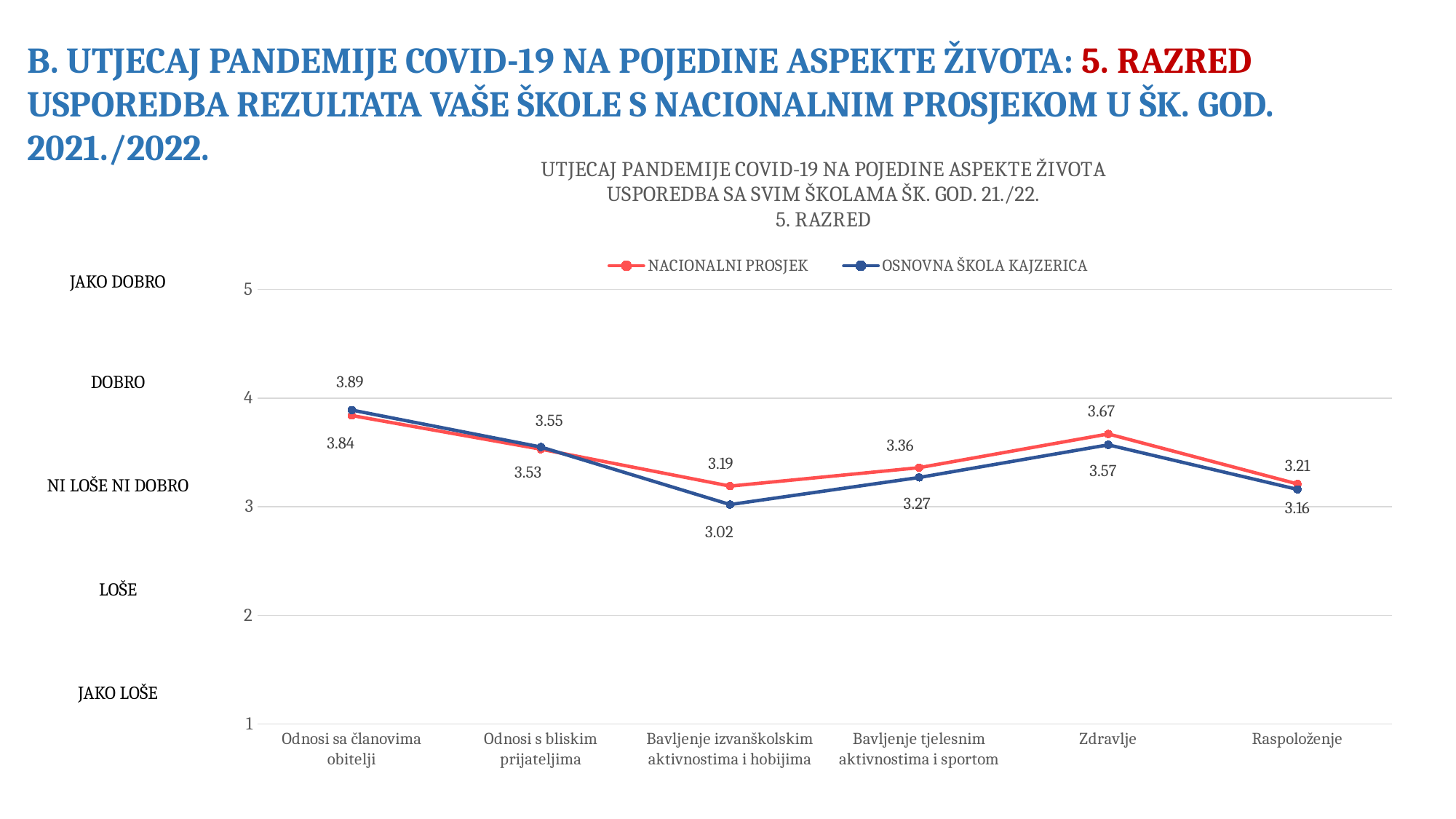
What is the OSNOVNA ŠKOLA KAJZERICA value for Bavljenje izvanškolskim aktivnostima i hobijima? 3.02 What is the NACIONALNI PROSJEK value for Bavljenje tjelesnim aktivnostima i sportom? 3.36 What is the NACIONALNI PROSJEK value for Zdravlje? 3.67 What is the difference between the NACIONALNI PROSJEK and OSNOVNA ŠKOLA KAJZERICA values for Zdravlje? 0.1 Which colour is used for the NACIONALNI PROSJEK line in the chart? red For which category is the NACIONALNI PROSJEK value highest? Odnosi sa članovima obitelji What is the OSNOVNA ŠKOLA KAJZERICA value for Raspoloženje? 3.16 How many categories are shown along the x axis of the chart? 6 How many series does the chart legend list? 2 For which category is the OSNOVNA ŠKOLA KAJZERICA value lowest? Bavljenje izvanškolskim aktivnostima i hobijima What kind of chart is shown on the slide? line chart For Bavljenje tjelesnim aktivnostima i sportom, which series has the higher value? NACIONALNI PROSJEK